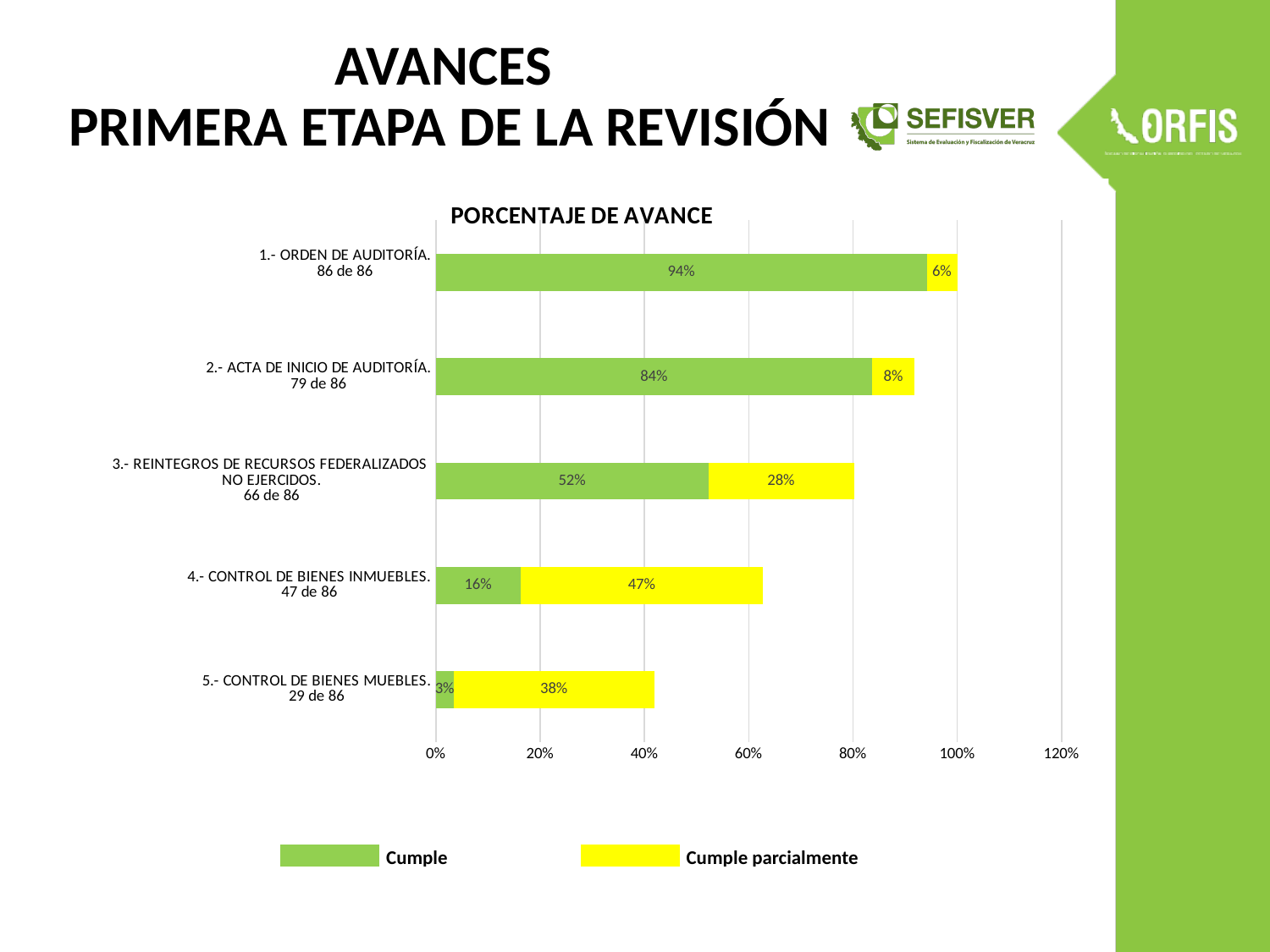
Which category has the lowest 'Cumple' value? 5.- CONTROL DE BIENES MUEBLES Which is larger for '4.- CONTROL DE BIENES INMUEBLES': the 'Cumple' value or the 'Cumple parcialmente' value? Cumple parcialmente What is the 'Cumple parcialmente' value for '3.- REINTEGROS DE RECURSOS FEDERALIZADOS NO EJERCIDOS'? 28% How many series does the legend list? 2 What kind of chart is shown on the slide? Stacked bar chart What is the title of the chart? PORCENTAJE DE AVANCE Which category has the highest 'Cumple' value? 1.- ORDEN DE AUDITORÍA What is the difference between the 'Cumple' values for '1.- ORDEN DE AUDITORÍA' and '2.- ACTA DE INICIO DE AUDITORÍA'? 10% What is the total of the stacked bar for '5.- CONTROL DE BIENES MUEBLES'? 41% What is the 'Cumple' value for '1.- ORDEN DE AUDITORÍA'? 94% How many categories are shown in the chart? 5 What is the 'Cumple' value for '4.- CONTROL DE BIENES INMUEBLES'? 16%